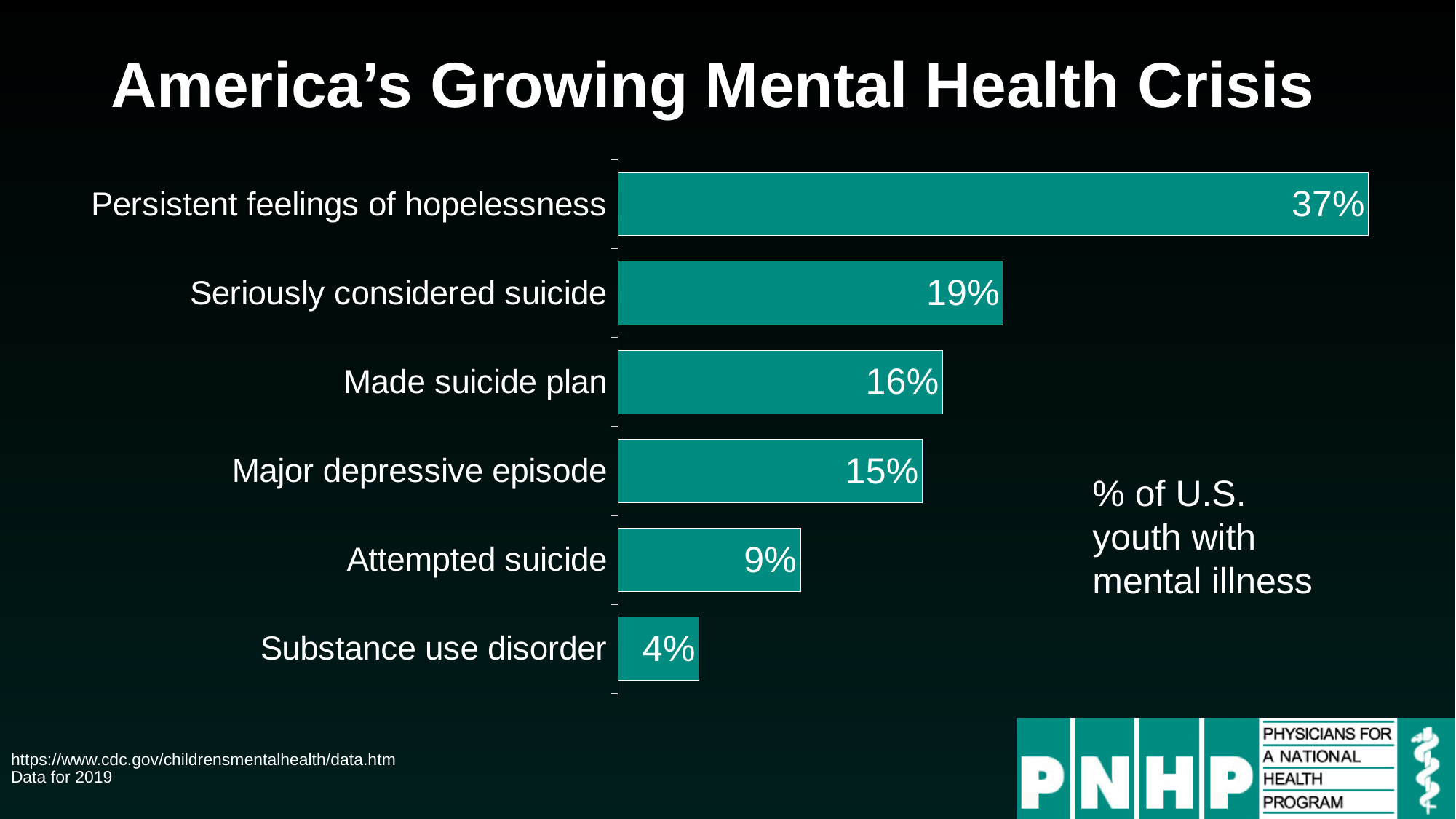
What is the difference between 'Major depressive episode' and 'Substance use disorder'? 11% What is the title of the slide containing the chart? America's Growing Mental Health Crisis How many categories are shown in the chart? 6 What kind of chart is shown on the slide? Bar chart Which category has the lowest value? Substance use disorder What is the value for 'Seriously considered suicide'? 19% Which category has the highest value? Persistent feelings of hopelessness Which is larger: 'Made suicide plan' or 'Major depressive episode'? Made suicide plan What percentage of U.S. youth with mental illness reported persistent feelings of hopelessness? 37% What is the value for 'Attempted suicide'? 9% What is the value for 'Made suicide plan'? 16% What is the difference between 'Persistent feelings of hopelessness' and 'Seriously considered suicide'? 18%